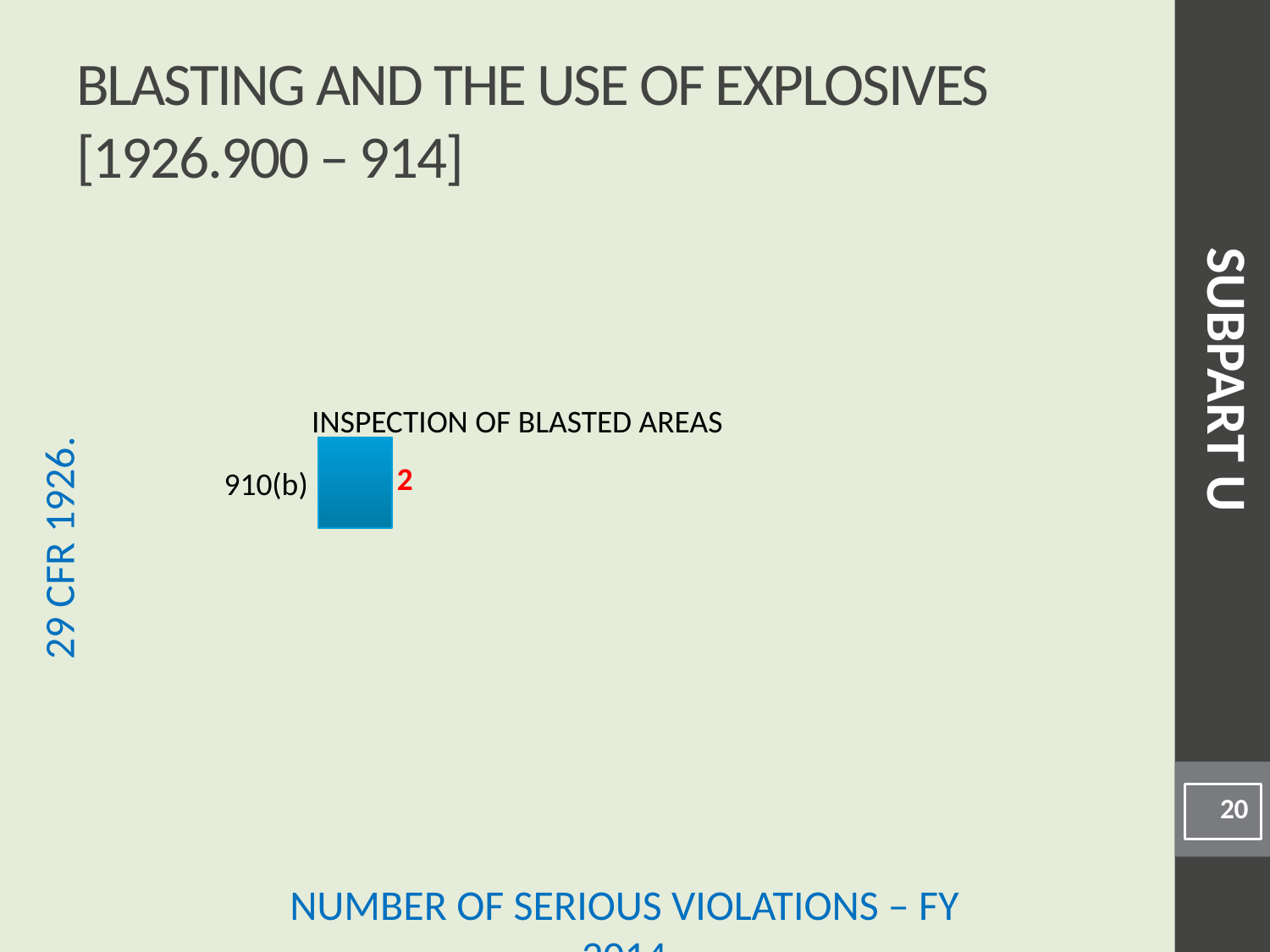
What is the title of the chart? INSPECTION OF BLASTED AREAS Which category has the highest value in the chart? 910(b) What kind of chart is shown on the slide? bar chart Which category label appears next to the bar in the chart? 910(b) How many categories are plotted in the chart? 1 What is the value for 910(b) in the chart? 2